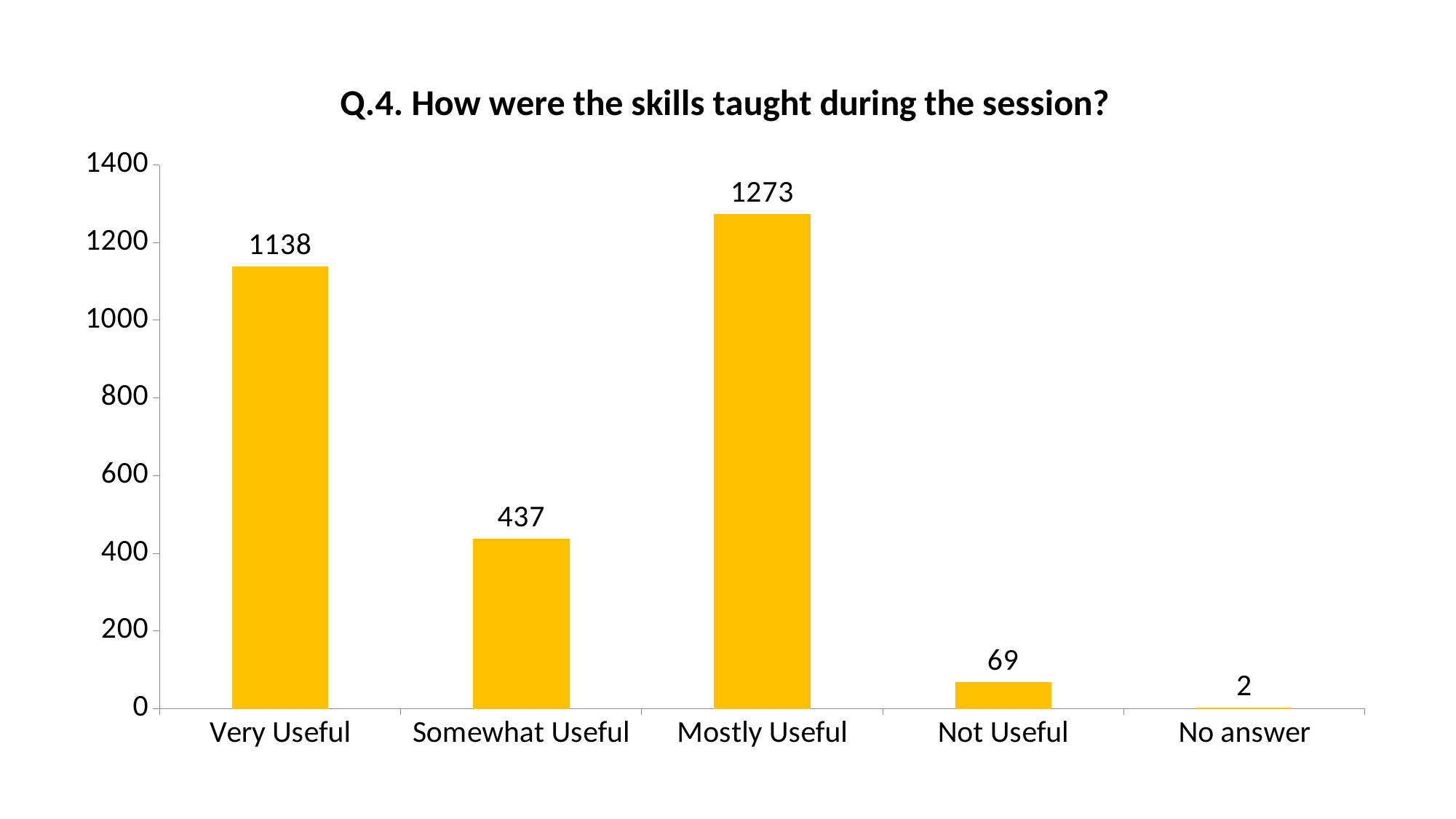
Is the value for Somewhat Useful greater or less than 600? less What is the value for Somewhat Useful? 437 Which is larger, the value for Somewhat Useful or the value for Not Useful? Somewhat Useful What kind of chart is shown on the slide? bar chart How many categories are shown on the x axis? 5 What is the value for No answer? 2 What is the value for Not Useful? 69 What is the title of the chart? Q.4. How were the skills taught during the session? What is the value for Very Useful? 1138 What is the difference between the values for Mostly Useful and Very Useful? 135 Which category has the lowest value? No answer Which category has the highest value? Mostly Useful